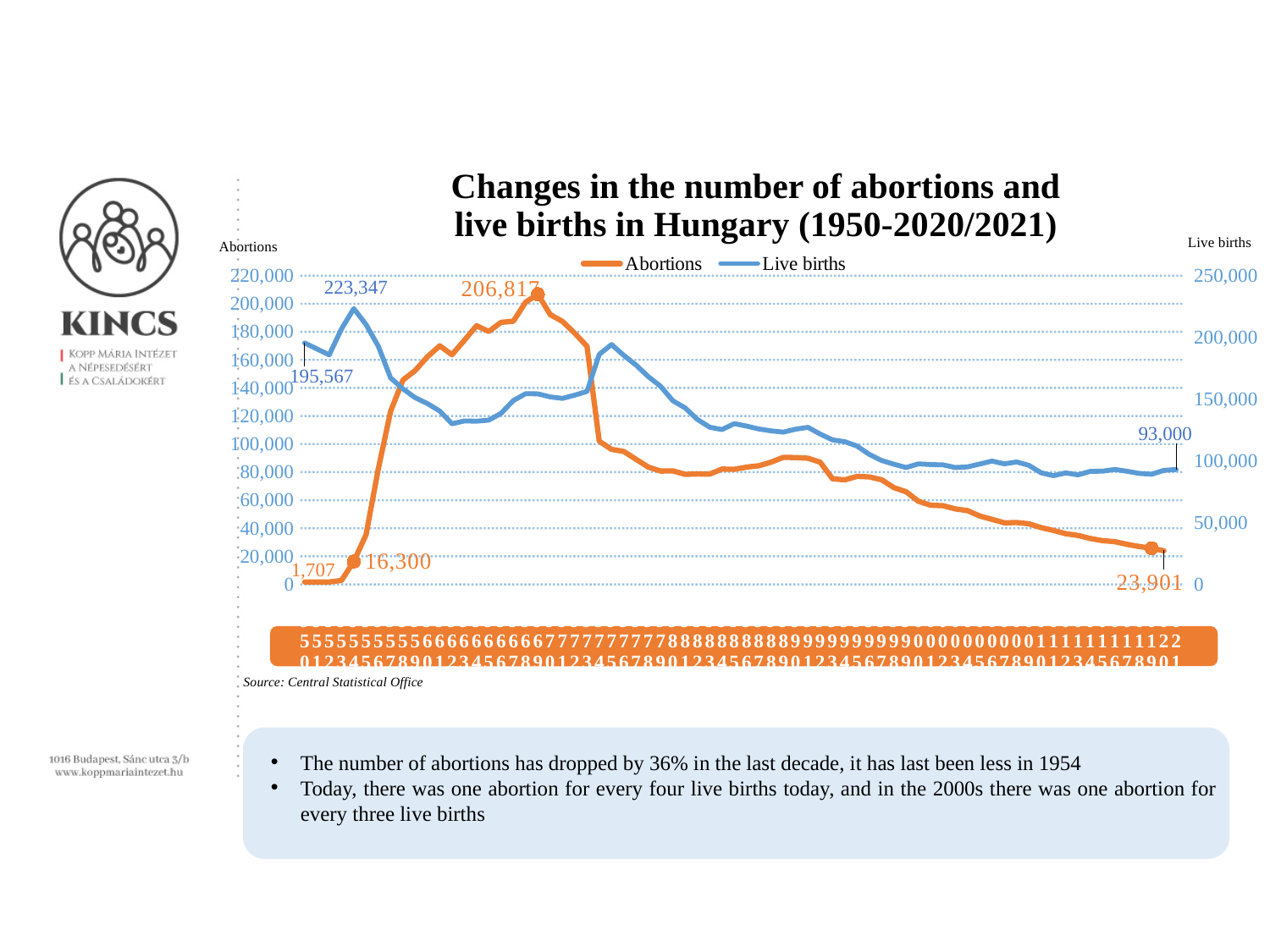
What is the highest labelled value of the Abortions series? 206,817 What is the difference between the peak Abortions value (206,817) and the final Abortions value (23,901)? 182,916 What is the labelled value of the Live births series at the left end of the chart? 195,567 Does the Abortions series rise or fall from its peak to the right end of the chart? fall What is the difference between the peak Live births value (223,347) and the final Live births value (93,000)? 130,347 What is the highest labelled value of the Live births series? 223,347 What is the labelled value of the Abortions series at the right end of the chart? 23,901 What kind of chart is shown on the slide? line chart What are the two series named in the chart's legend? Abortions and Live births What is the labelled value of the Live births series at the right end of the chart? 93,000 How many series does the chart's legend list? 2 What is the labelled value of the Abortions series at the left end of the chart? 1,707